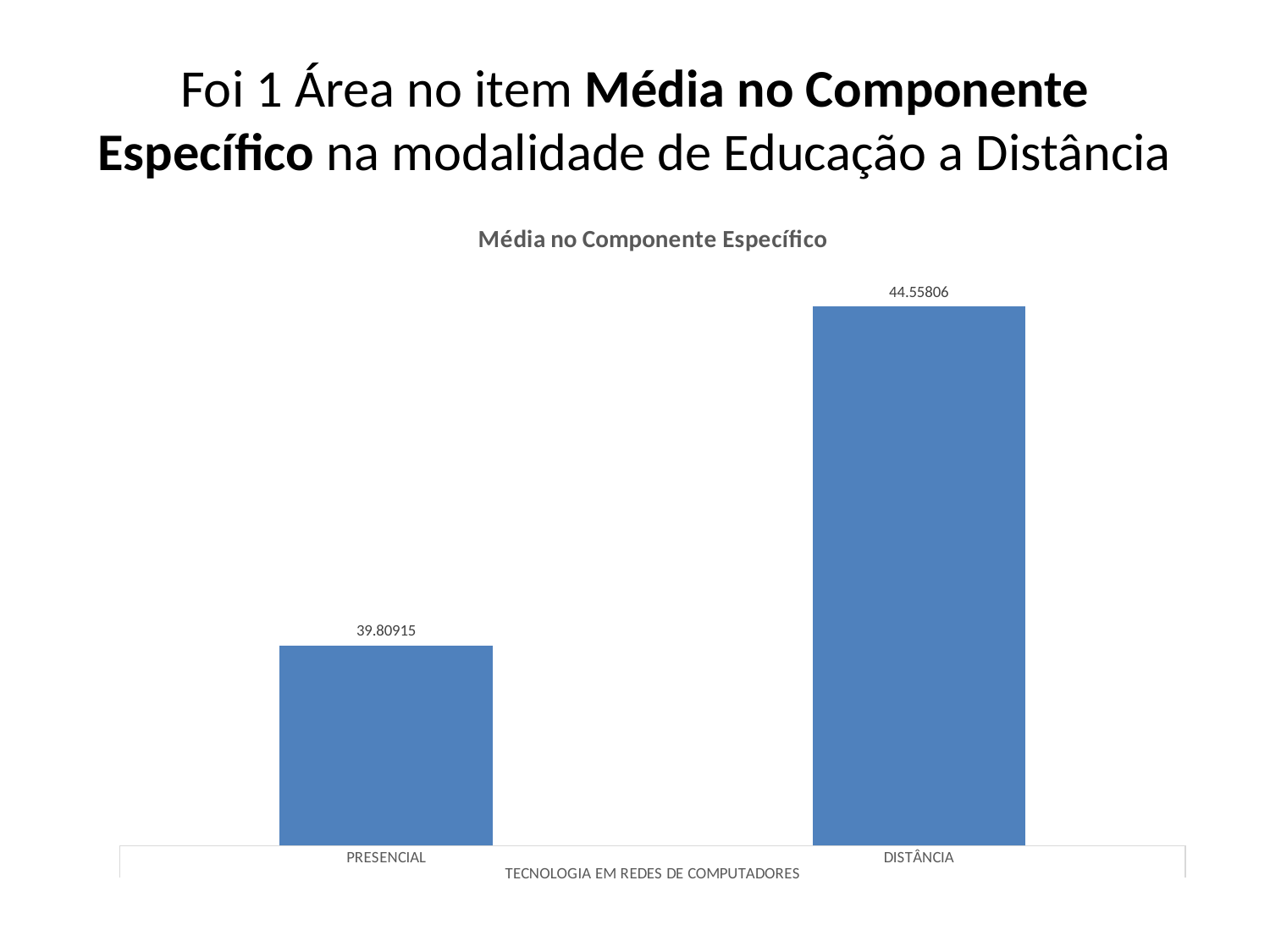
What is the value for DISTÂNCIA? 44.55806 What is the difference between the values for DISTÂNCIA and PRESENCIAL? 4.74891 Do the values rise or fall from PRESENCIAL to DISTÂNCIA? Rise Which category has the lowest value? PRESENCIAL Which is larger, the value for PRESENCIAL or the value for DISTÂNCIA? DISTÂNCIA Which category has the highest value? DISTÂNCIA What kind of chart is shown on the slide? Bar chart What is the label shown below the category axis of the chart? TECNOLOGIA EM REDES DE COMPUTADORES What is the title of the chart? Média no Componente Específico How many categories are shown in the chart? 2 What is the value for PRESENCIAL? 39.80915